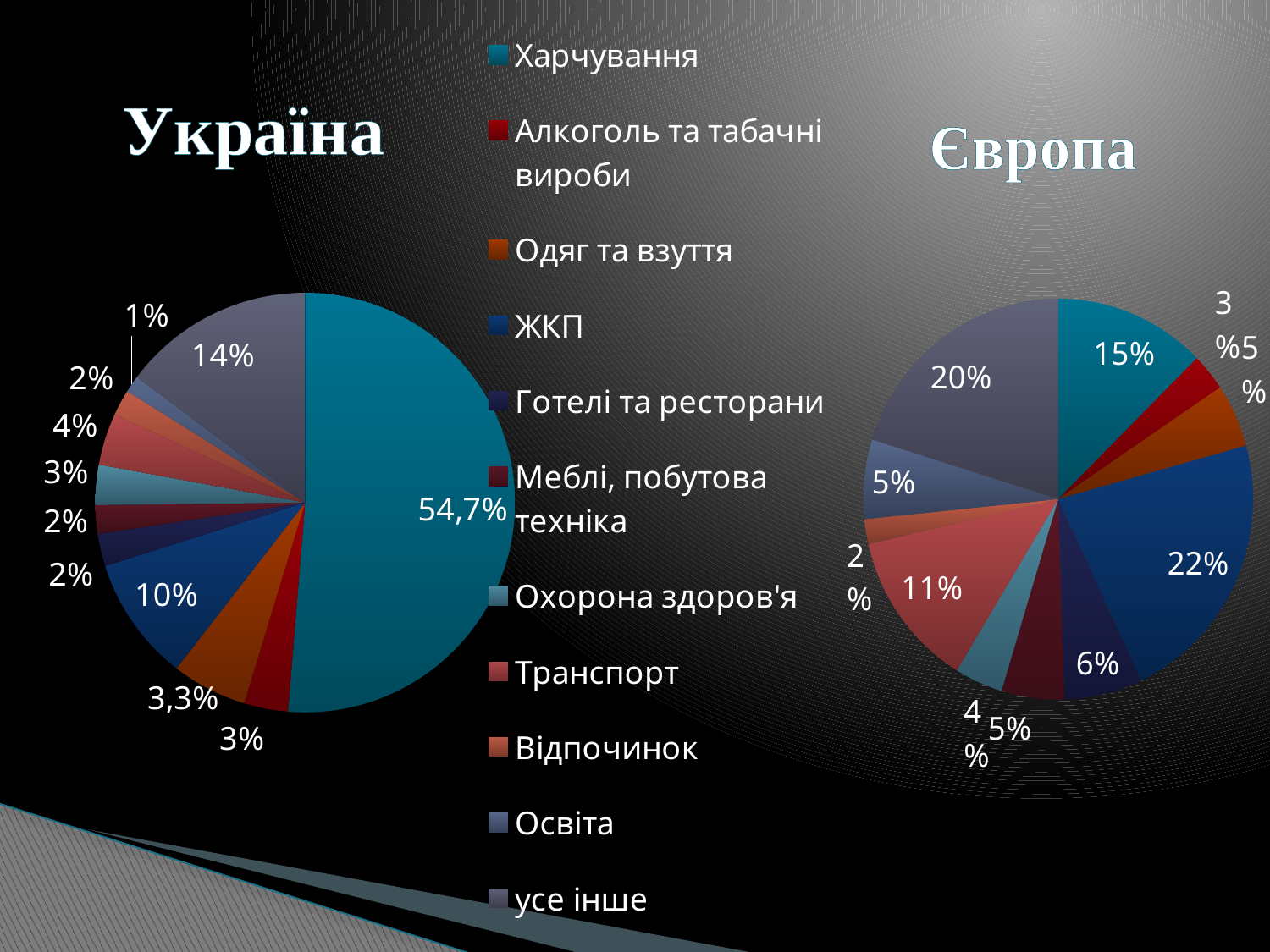
In the Європа chart, which category has the largest slice? ЖКП How many categories does the legend list? 11 In the Україна chart, how many percentage points larger is Харчування than усе інше? 40,7 In the Європа chart, what share does Транспорт have? 11% Which chart shows a larger share for Транспорт, Україна or Європа? Європа In the Україна chart, what share does Харчування have? 54,7% In the Україна chart, what share does усе інше have? 14% In the Україна chart, which category has the smallest slice? Освіта What kind of chart is used on the slide for Україна and Європа? Pie chart In the Європа chart, what share does ЖКП have? 22% In the Україна chart, which category has the largest slice? Харчування In the Європа chart, what share does усе інше have? 20%